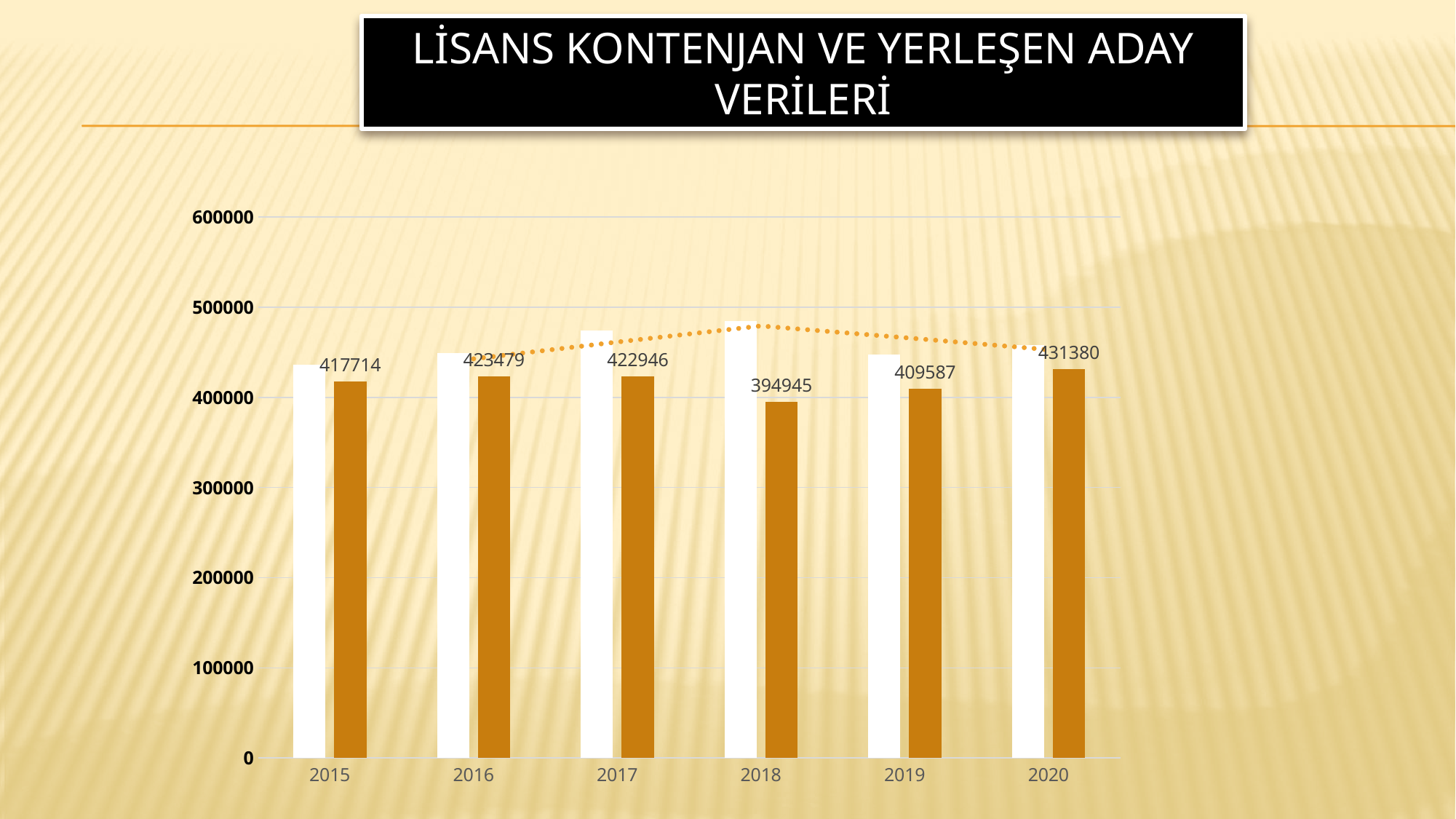
How many years are shown on the x axis? 6 Which year has the highest labelled orange bar value? 2020 What is the value shown on the orange bar for 2015? 417714 What is the value shown on the orange bar for 2018? 394945 Which year has the larger orange bar value, 2015 or 2020? 2020 What is the title of the slide? LİSANS KONTENJAN VE YERLEŞEN ADAY VERİLERİ What is the value shown on the orange bar for 2019? 409587 Is the value of the white bar for 2018 greater or less than 400000? greater What kind of chart is shown on the slide? bar chart What is the value shown on the orange bar for 2020? 431380 Which year has the lowest labelled orange bar value? 2018 What is the difference between the orange bar values for 2020 and 2018? 36435